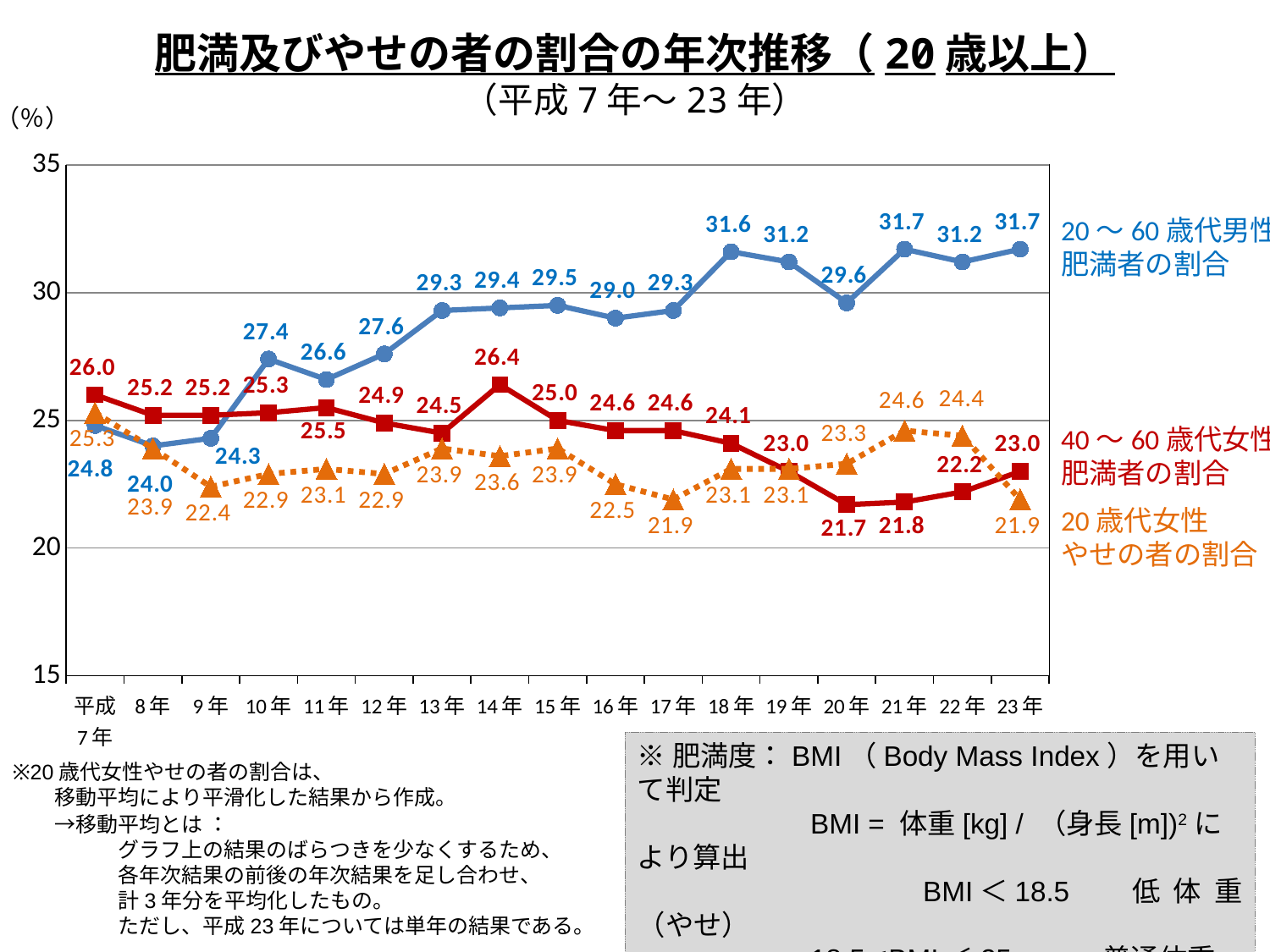
What is the value for 40～60歳代女性肥満者の割合 in 平成14年? 26.4 What is the difference between 20～60歳代男性肥満者の割合 in 平成23年 (31.7) and 平成7年 (24.8)? 6.9 How many series are plotted in the chart? 3 Overall, does 20～60歳代男性肥満者の割合 rise or fall from 平成7年 to 平成23年? rise What is the value for 20歳代女性やせの者の割合 in 平成9年? 22.4 What is the value for 20～60歳代男性肥満者の割合 in 平成23年? 31.7 Which is larger in 平成7年: 40～60歳代女性肥満者の割合 or 20歳代女性やせの者の割合? 40～60歳代女性肥満者の割合 In which year is 40～60歳代女性肥満者の割合 lowest? 平成20年 What is the lowest value of 20～60歳代男性肥満者の割合 across the period? 24.0 How many years (data points) are plotted along the x axis? 17 Which series is drawn with a dotted line? 20歳代女性やせの者の割合 What type of chart is shown on the slide? line chart